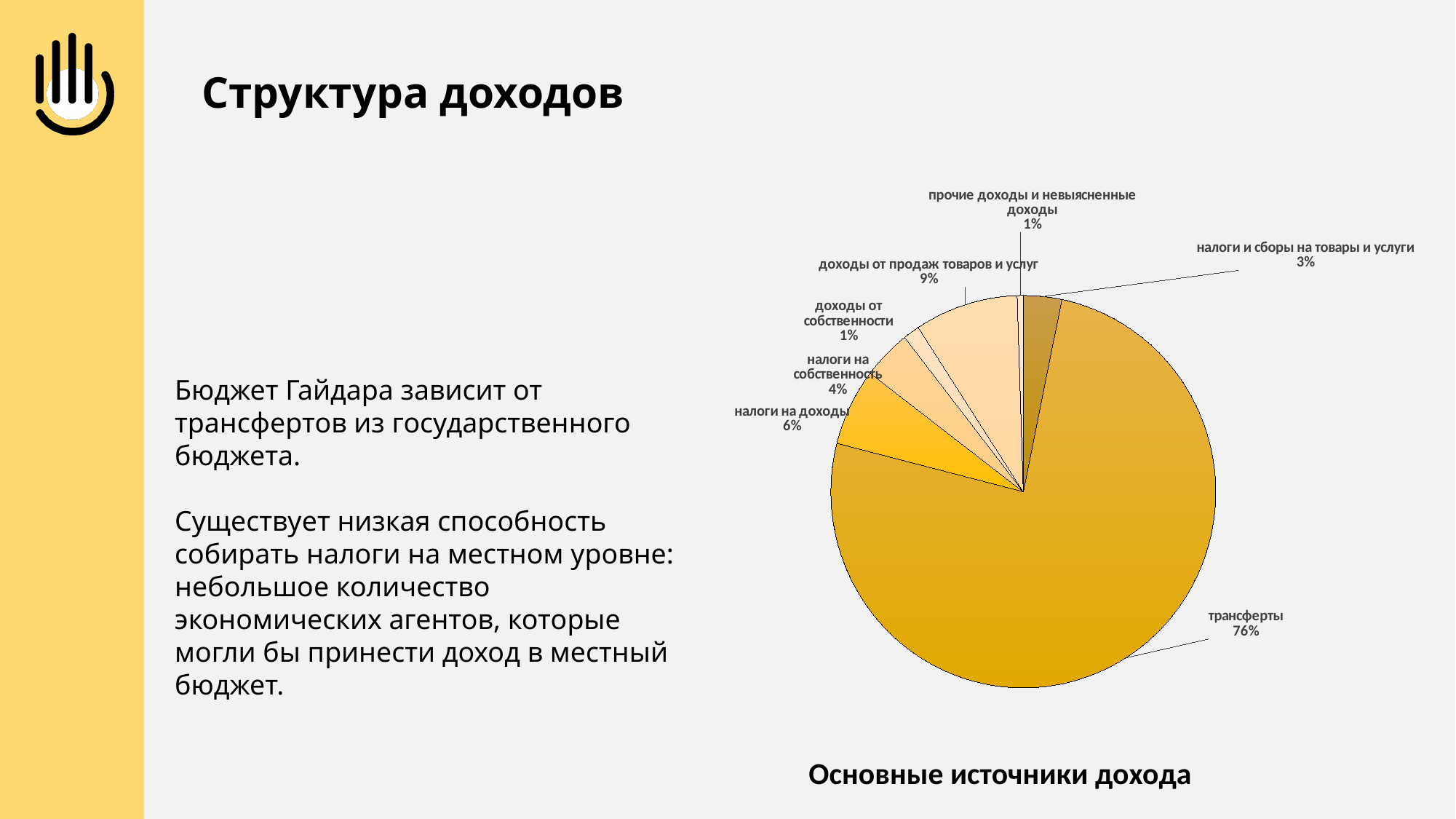
What is the value shown for "доходы от собственности"? 1% What is the value shown for "доходы от продаж товаров и услуг"? 9% What is the value shown for "налоги и сборы на товары и услуги"? 3% How many slices does the pie chart have? 7 What is the value shown for "налоги на доходы"? 6% What is the value shown for "налоги на собственность"? 4% Which category has the largest slice of the pie? трансферты What is the title shown below the pie chart? Основные источники дохода What share of the pie does "трансферты" have? 76% Which is larger, the share of "налоги на доходы" or the share of "налоги на собственность"? налоги на доходы What kind of chart is shown on the slide? pie chart What is the difference between the shares of "трансферты" and "доходы от продаж товаров и услуг"? 67%